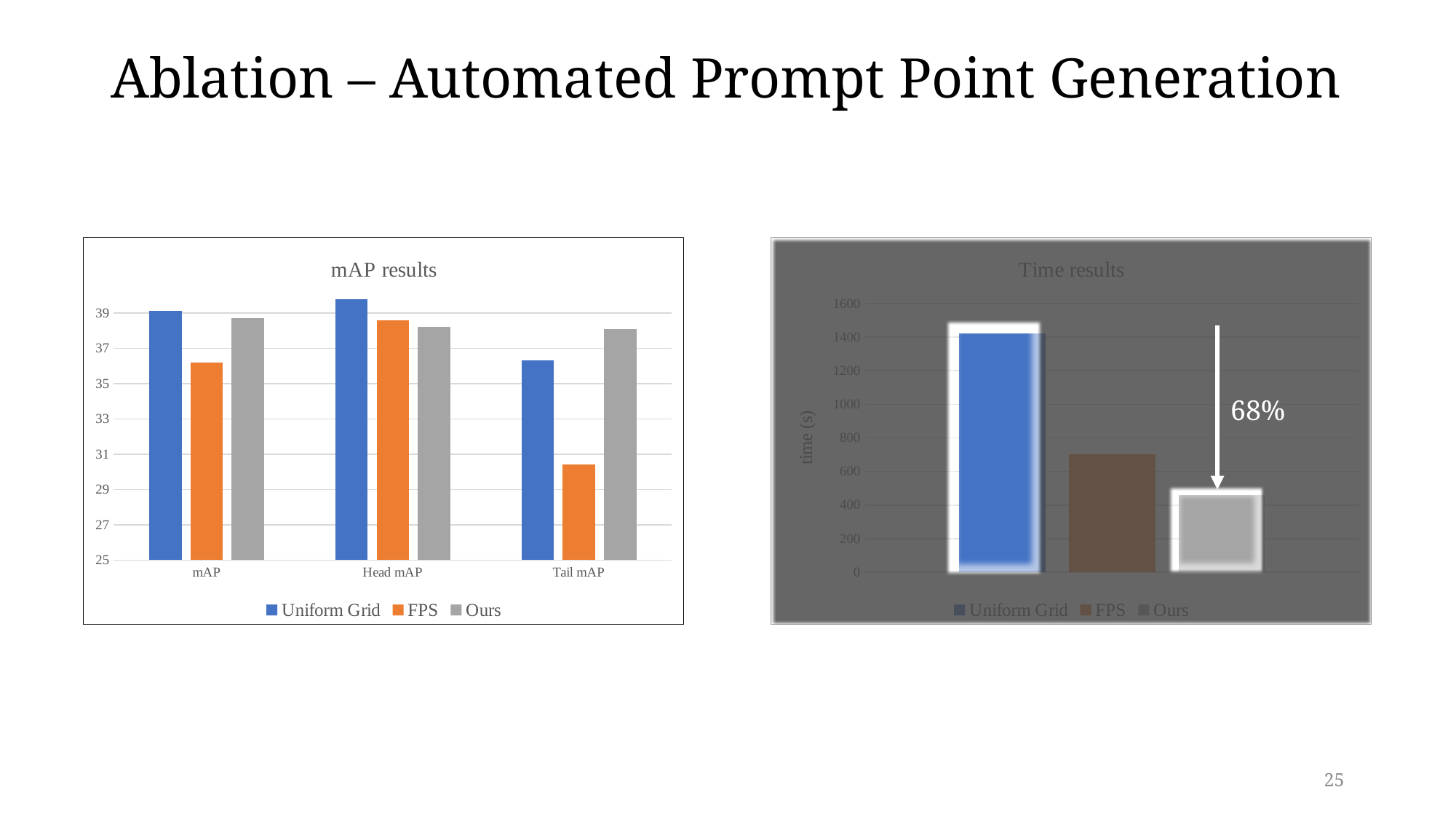
In the "mAP results" chart, is the Uniform Grid value for Head mAP greater or less than 39? greater In the "mAP results" chart, is the FPS value for Tail mAP greater or less than 31? less In the "mAP results" chart, which series has the lowest value for Tail mAP? FPS In the "mAP results" chart, which is larger for Tail mAP: Uniform Grid or Ours? Ours How many categories are shown on the x axis of the "mAP results" chart? 3 In the "mAP results" chart, which is larger for mAP: FPS or Ours? Ours What is the y-axis label of the "Time results" chart? time (s) In the "Time results" chart, is the value for Uniform Grid greater or less than 1200? greater In the "Time results" chart, which series has the highest time? Uniform Grid What kind of chart is the "mAP results" chart? bar chart How many series does the legend of the "mAP results" chart list? 3 In the "Time results" chart, which series has the lowest time? Ours